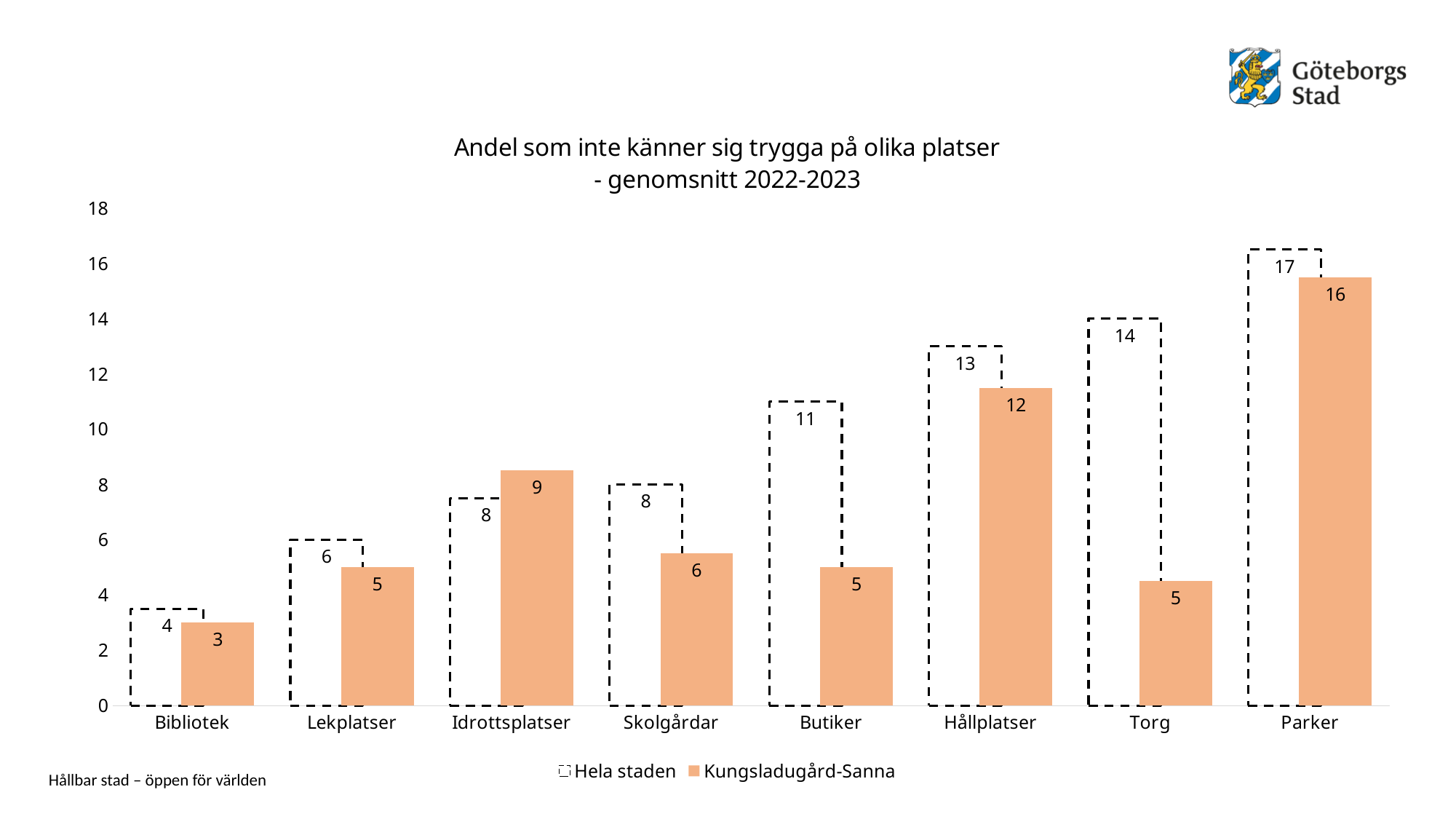
What is the value for Kungsladugård-Sanna at Parker? 16 Which is larger at Idrottsplatser, Hela staden or Kungsladugård-Sanna? Kungsladugård-Sanna What is the value for Kungsladugård-Sanna at Torg? 5 What is the difference between Hela staden and Kungsladugård-Sanna at Torg? 9 What is the value for Hela staden at Butiker? 11 Which category has the highest value for Hela staden? Parker Is the value for Hela staden at Hållplatser greater or less than 10? greater Which category has the lowest value for Kungsladugård-Sanna? Bibliotek How many categories are shown on the x axis? 8 How many series does the legend list? 2 What is the title of the chart? Andel som inte känner sig trygga på olika platser - genomsnitt 2022-2023 What kind of chart is shown on the slide? Bar chart